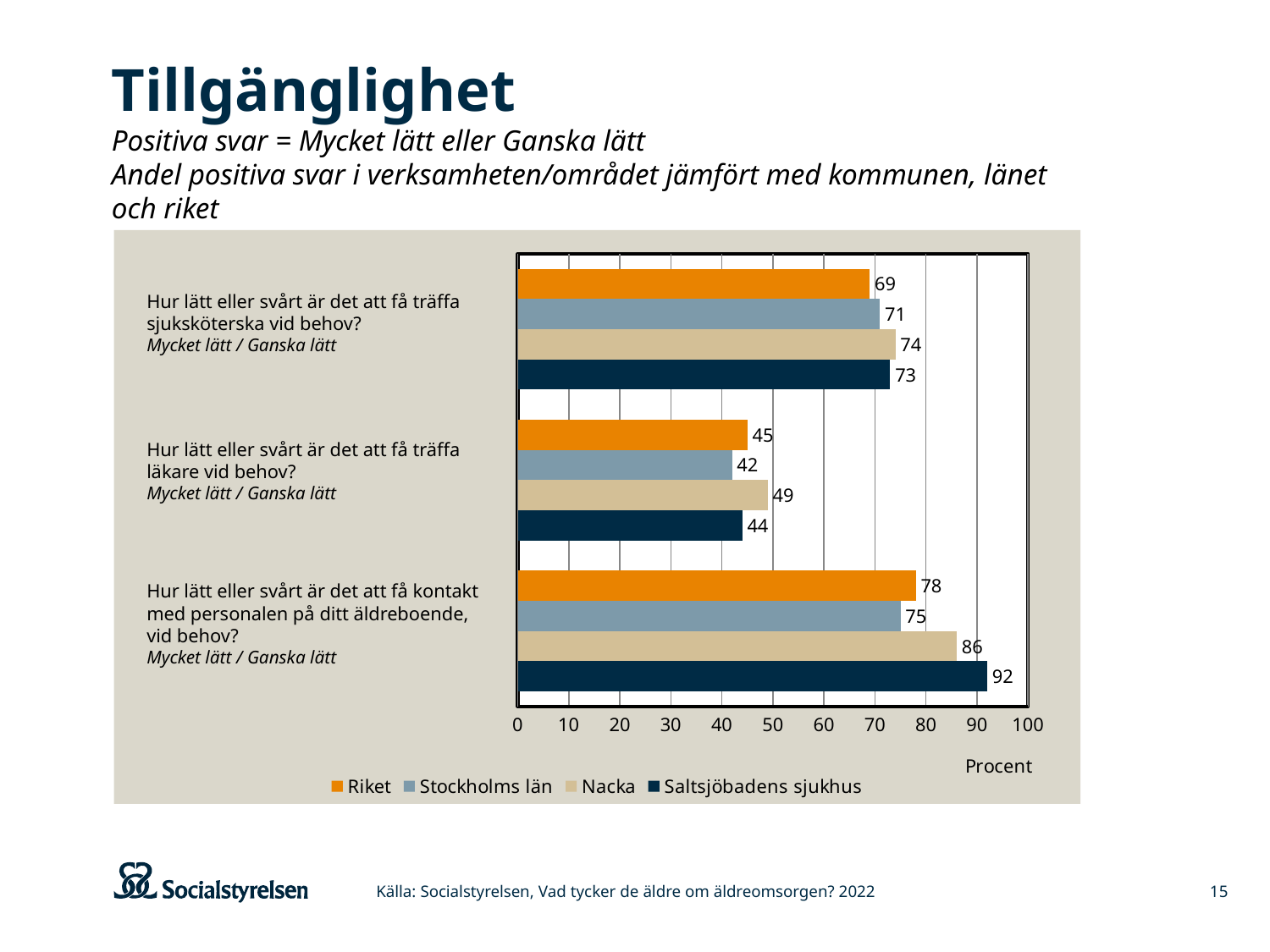
Which is larger on the question about meeting a nurse when needed: the value for Nacka or the value for Riket? Nacka What is the value for Stockholms län on the question about meeting a nurse when needed ("Hur lätt eller svårt är det att få träffa sjuksköterska vid behov?")? 71 How many series does the legend list? 4 What is the value for Saltsjöbadens sjukhus on the question about getting in contact with staff at the care home ("Hur lätt eller svårt är det att få kontakt med personalen på ditt äldreboende, vid behov?")? 92 What unit label is shown under the x axis of the chart? Procent Which series has the lowest value on the question about meeting a doctor when needed? Stockholms län What is the difference between Saltsjöbadens sjukhus and Riket on the question about getting in contact with staff at the care home? 14 What is the value for Nacka on the question about meeting a doctor when needed ("Hur lätt eller svårt är det att få träffa läkare vid behov?")? 49 Is the value for Saltsjöbadens sjukhus on the question about meeting a doctor when needed greater or less than 50? less How many questions (categories) are shown on the chart? 3 Which series has the highest value on the question about getting in contact with staff at the care home? Saltsjöbadens sjukhus What kind of chart is shown on the slide? Bar chart